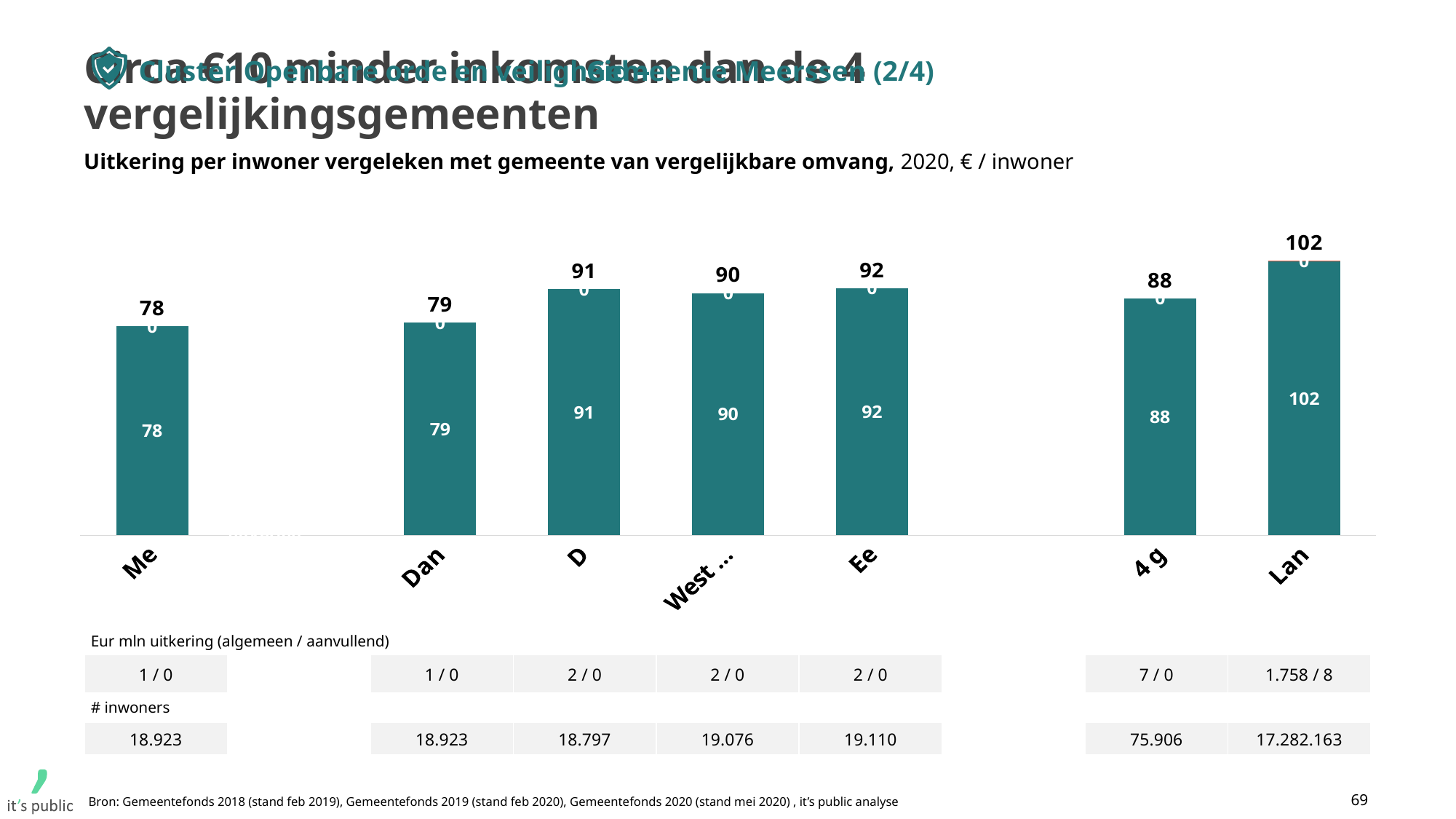
What is the value for the bar labelled "Lan"? 102 What is the difference between the values for "Lan" and "Me"? 24 What is the value for the bar labelled "Ee"? 92 What kind of chart is shown on the slide? Bar chart What is the value for the bar labelled "Me"? 78 Which category has the lowest bar? Me How many bars are shown in the chart? 7 Which is larger, the value for "D" or the value for "West ..."? D Which category has the highest bar? Lan What unit is stated in the chart subtitle for the plotted values? € / inwoner What is the value for the bar labelled "4 g"? 88 What is the difference between the values for "Ee" and "4 g"? 4